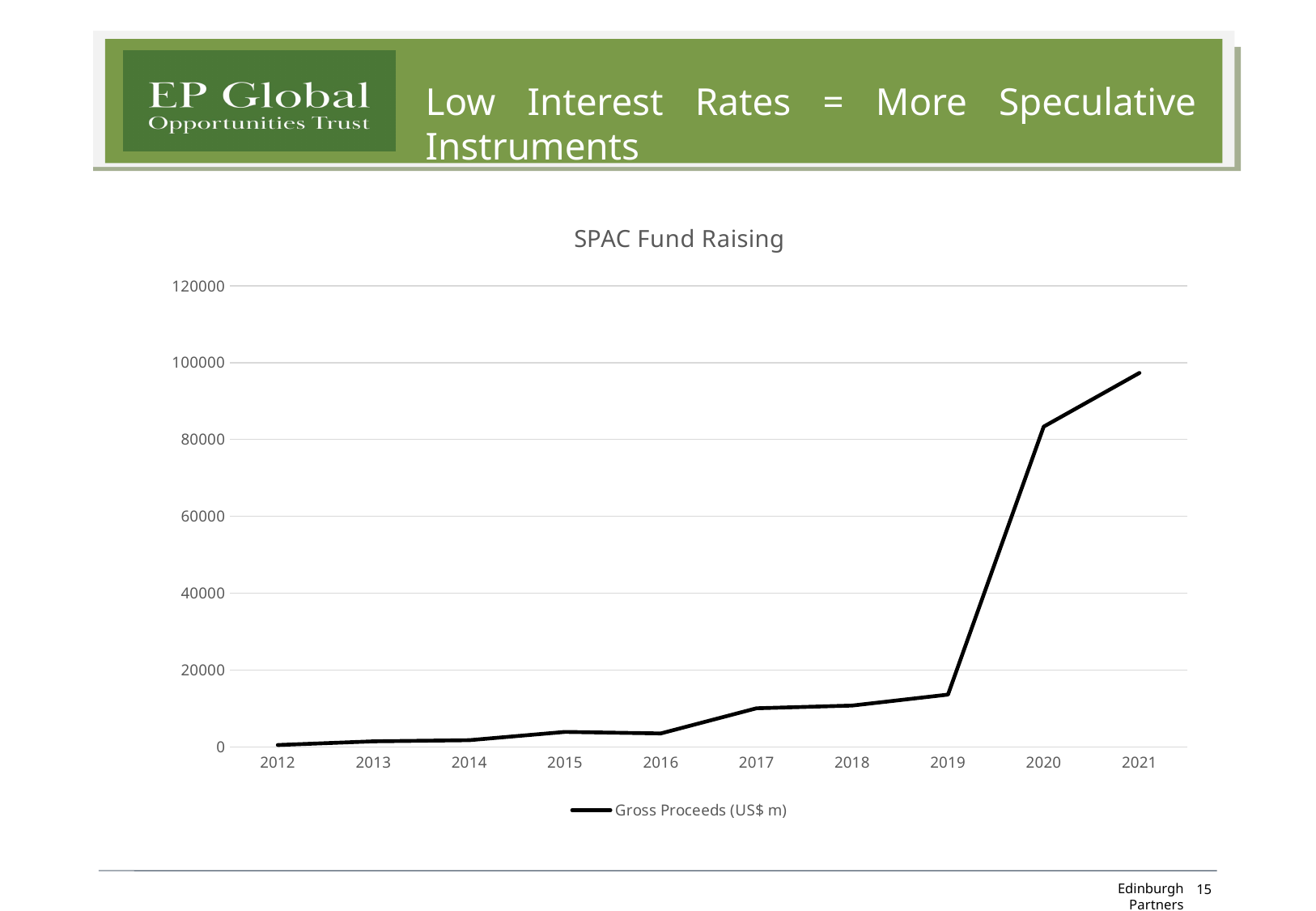
How many series does the legend list? 1 Is the value for 2020 greater or less than 60000? greater Do gross proceeds generally rise or fall from 2012 to 2021? rise Which year has the highest gross proceeds? 2021 Which year has larger gross proceeds, 2019 or 2020? 2020 What kind of chart is shown on the slide? line chart What series does the legend list? Gross Proceeds (US$ m) How many years are plotted on the x axis? 10 Is the value for 2021 greater or less than 80000? greater Which year has the lowest gross proceeds? 2012 Is the value for 2019 greater or less than 20000? less What is the title of the chart? SPAC Fund Raising